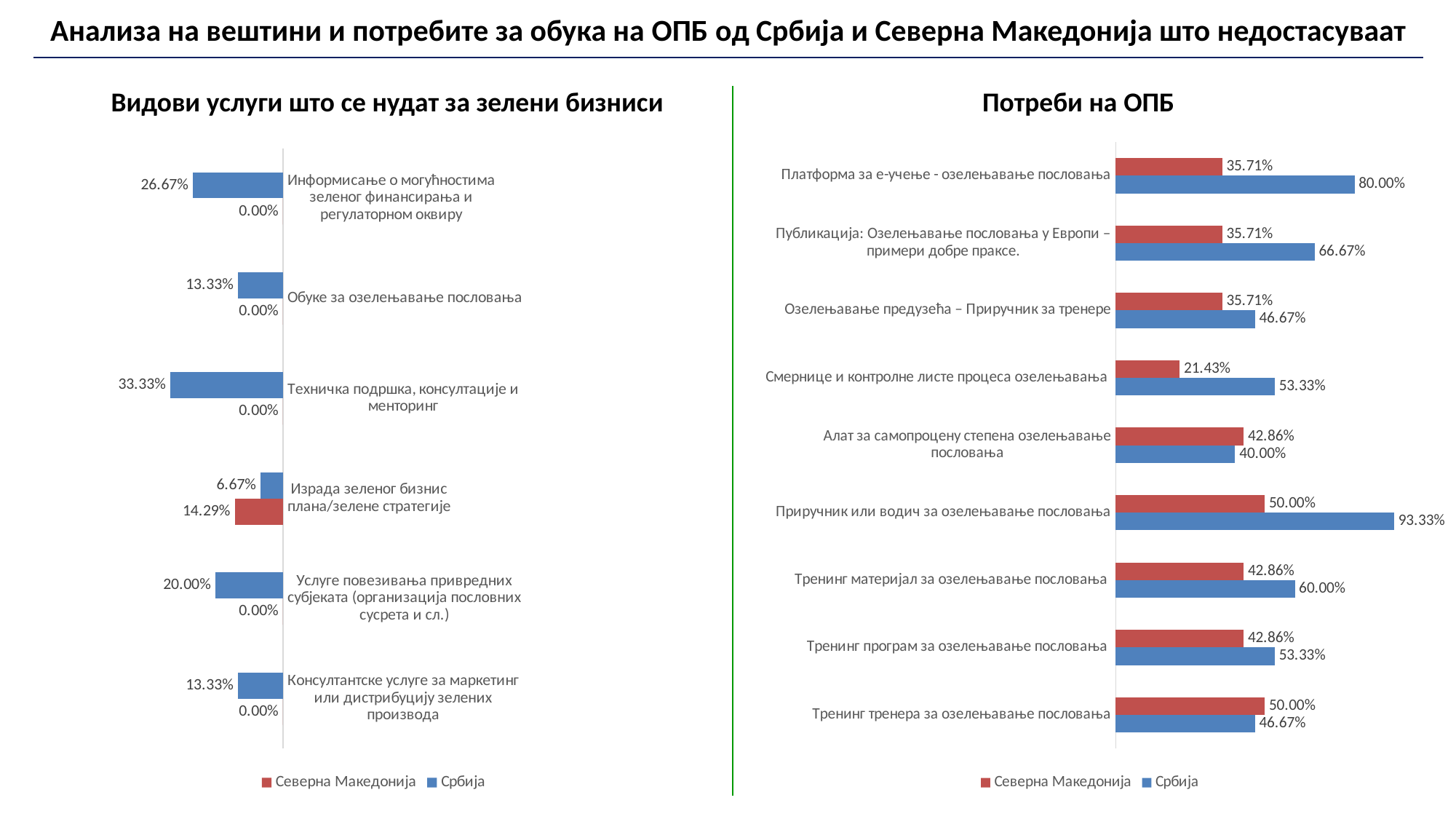
In the chart "Видови услуги што се нудат за зелени бизниси", what is the value for Србија for "Техничка подршка, консултације и менторинг"? 33.33% In the chart "Видови услуги што се нудат за зелени бизниси", what is the difference between the Србија values for "Информисање о могућностима зеленог финансирања и регулаторном оквиру" and "Обуке за озелењавање пословања"? 13.34% In the chart "Потреби на ОПБ", which category has the lowest value for Северна Македонија? Смернице и контролне листе процеса озелењавања In the chart "Потреби на ОПБ", what is the difference between the Србија and Северна Македонија values for "Платформа за е-учење - озелењавање пословања"? 44.29% In the chart "Видови услуги што се нудат за зелени бизниси", how many categories are shown? 6 In the chart "Потреби на ОПБ", for "Тренинг тренера за озелењавање пословања", which is larger: the value for Северна Македонија or for Србија? Северна Македонија In the chart "Видови услуги што се нудат за зелени бизниси", what is the value for Северна Македонија for "Израда зеленог бизнис плана/зелене стратегије"? 14.29% In the chart "Видови услуги што се нудат за зелени бизниси", which category has the highest value for Србија? Техничка подршка, консултације и менторинг In the chart "Потреби на ОПБ", what is the value for Северна Македонија for "Смернице и контролне листе процеса озелењавања"? 21.43% In the chart "Потреби на ОПБ", how many categories are shown? 9 In the chart "Потреби на ОПБ", what is the value for Србија for "Приручник или водич за озелењавање пословања"? 93.33% How many series does the legend of the chart "Потреби на ОПБ" list? 2